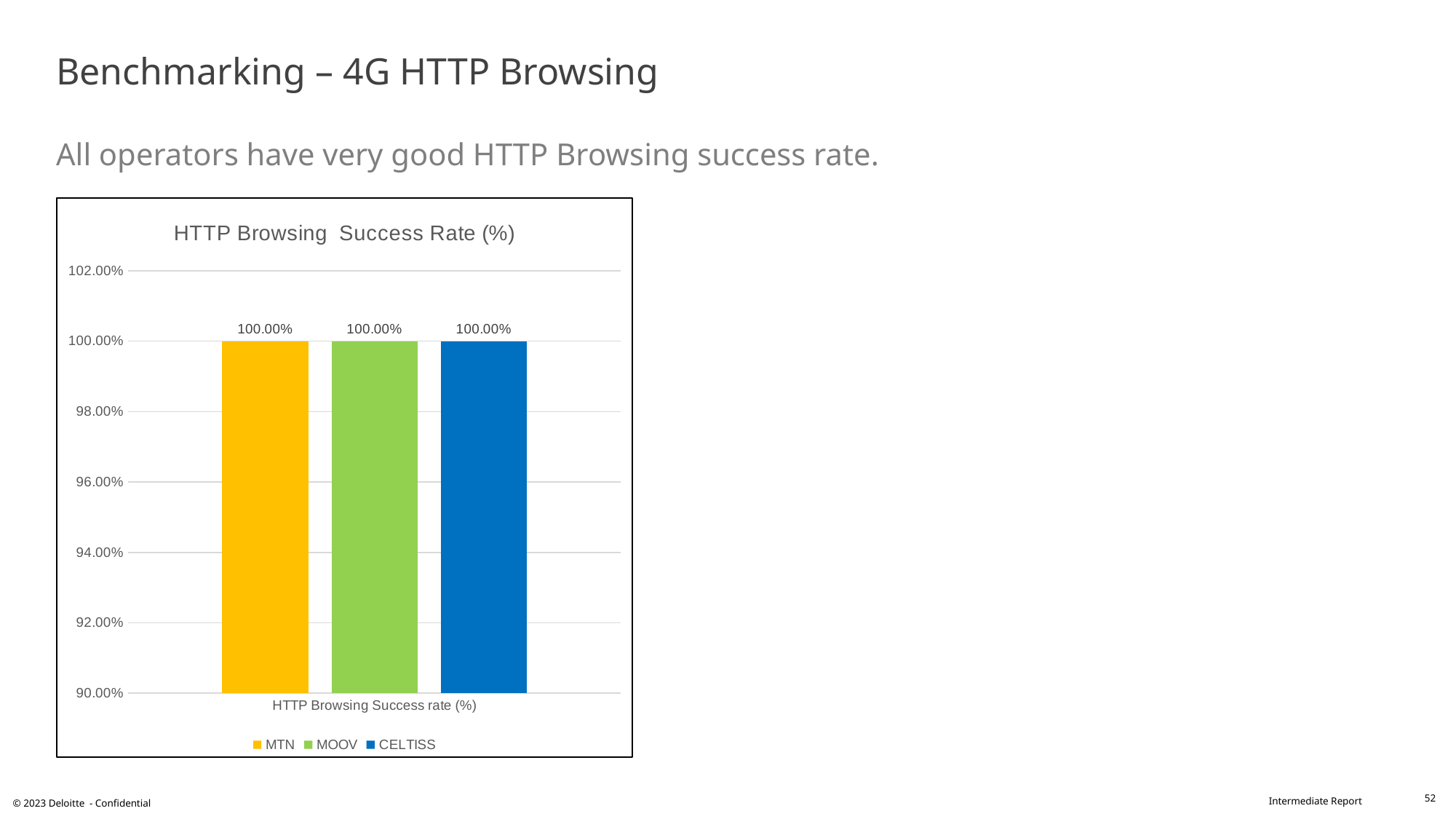
What kind of chart is shown on the slide? bar chart What is the title of the chart? HTTP Browsing Success Rate (%) How many series does the legend list? 3 What is the HTTP Browsing success rate for CELTISS? 100.00% What is the HTTP Browsing success rate for MOOV? 100.00% Which operator is represented by the blue bar? CELTISS Is the HTTP Browsing success rate for MOOV greater or less than 98.00%? greater What is the difference between the HTTP Browsing success rates of MTN and CELTISS? 0.00% What is the lowest value shown on the vertical axis? 90.00% What is the HTTP Browsing success rate for MTN? 100.00%